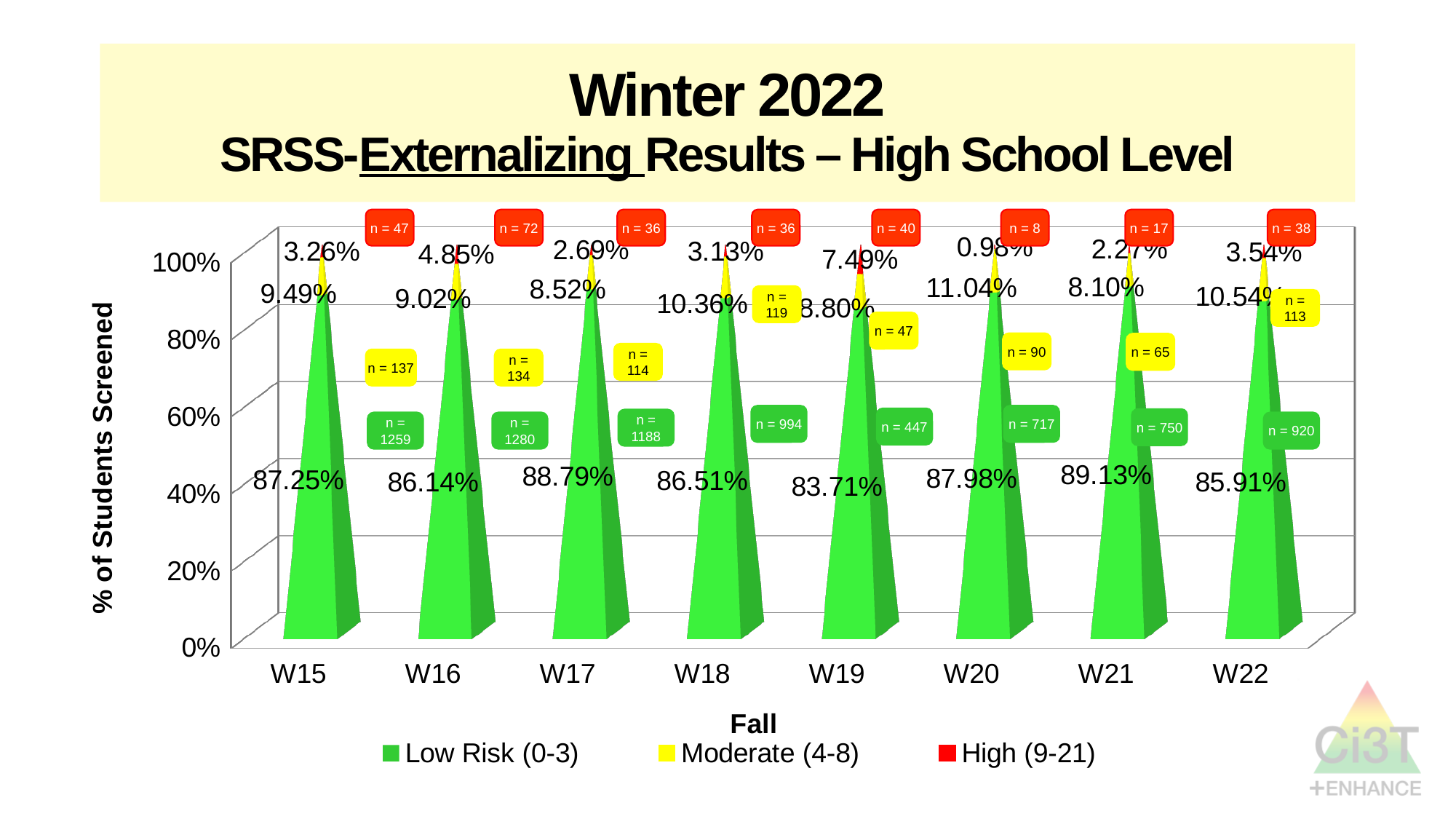
What is the difference between the High (9-21) percentages for W19 and W20? 6.51% What kind of chart is shown on the slide? Stacked bar chart What is the title of the x axis? Fall What is the High (9-21) percentage for W19? 7.49% What is the Low Risk (0-3) percentage for W17? 88.79% What is the Moderate (4-8) percentage for W20? 11.04% Which is larger, the Moderate (4-8) percentage for W18 or for W16? W18 Which category has the lowest High (9-21) percentage? W20 How many series does the legend list? 3 How many categories are shown on the x axis? 8 Which category has the highest Moderate (4-8) percentage? W20 Which category has the highest Low Risk (0-3) percentage? W21